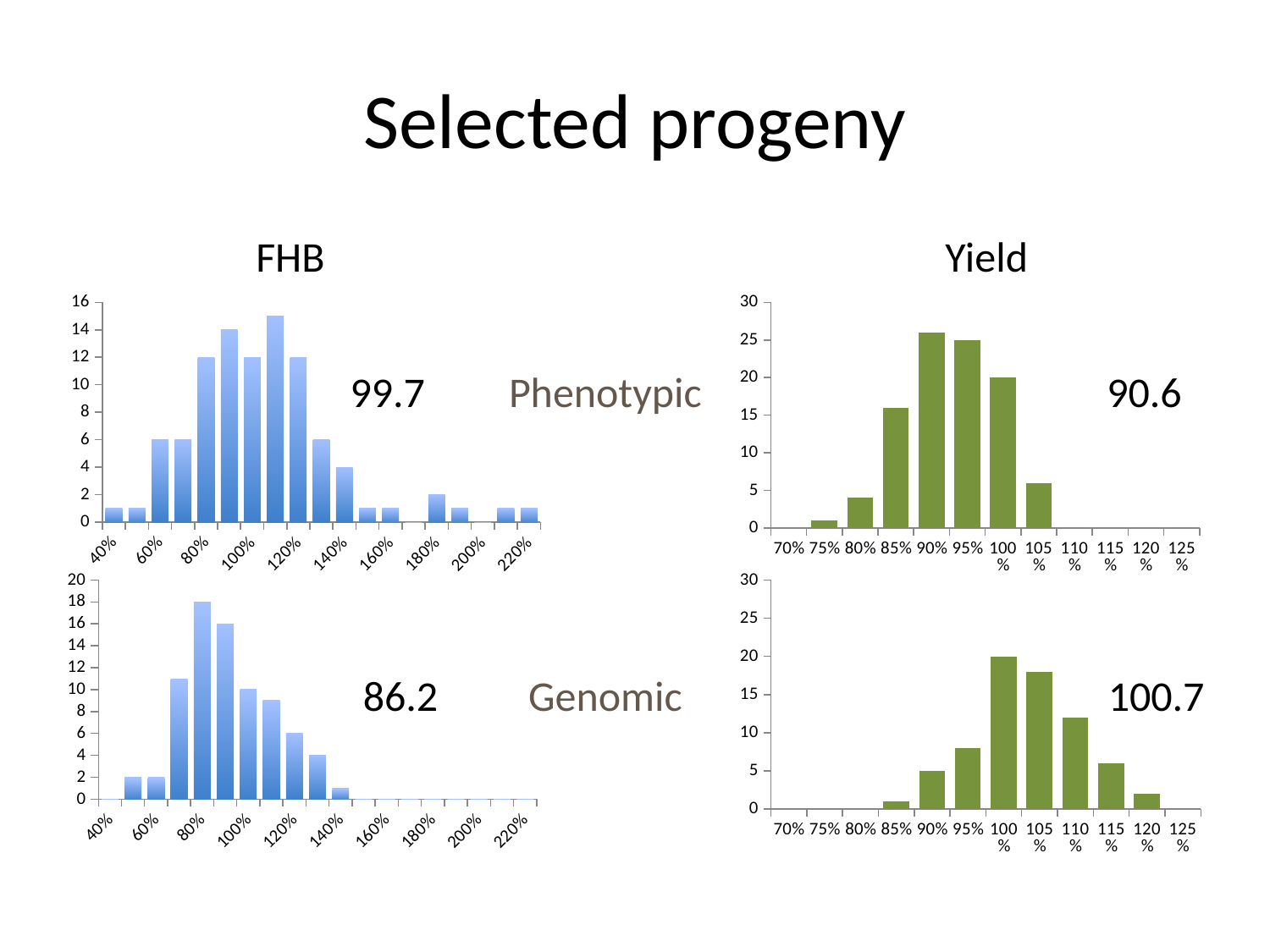
In the FHB Phenotypic chart (top left), what is the value for 90%? 14 What kind of chart is the FHB Phenotypic chart (top left)? bar chart What colour are the bars in the Yield charts on the right side of the slide? green In the Yield Phenotypic chart (top right), which is larger, the value for 85% or the value for 105%? 85% In the FHB Genomic chart (bottom left), what is the value for 80%? 18 In the FHB Genomic chart (bottom left), which category has the highest bar? 80% In the Yield Phenotypic chart (top right), what is the value for 100%? 20 In the Yield Genomic chart (bottom right), what is the value for 100%? 20 In the FHB Genomic chart (bottom left), what is the value for 90%? 16 How many charts are on the slide? 4 In the Yield Genomic chart (bottom right), which category has the highest bar? 100%